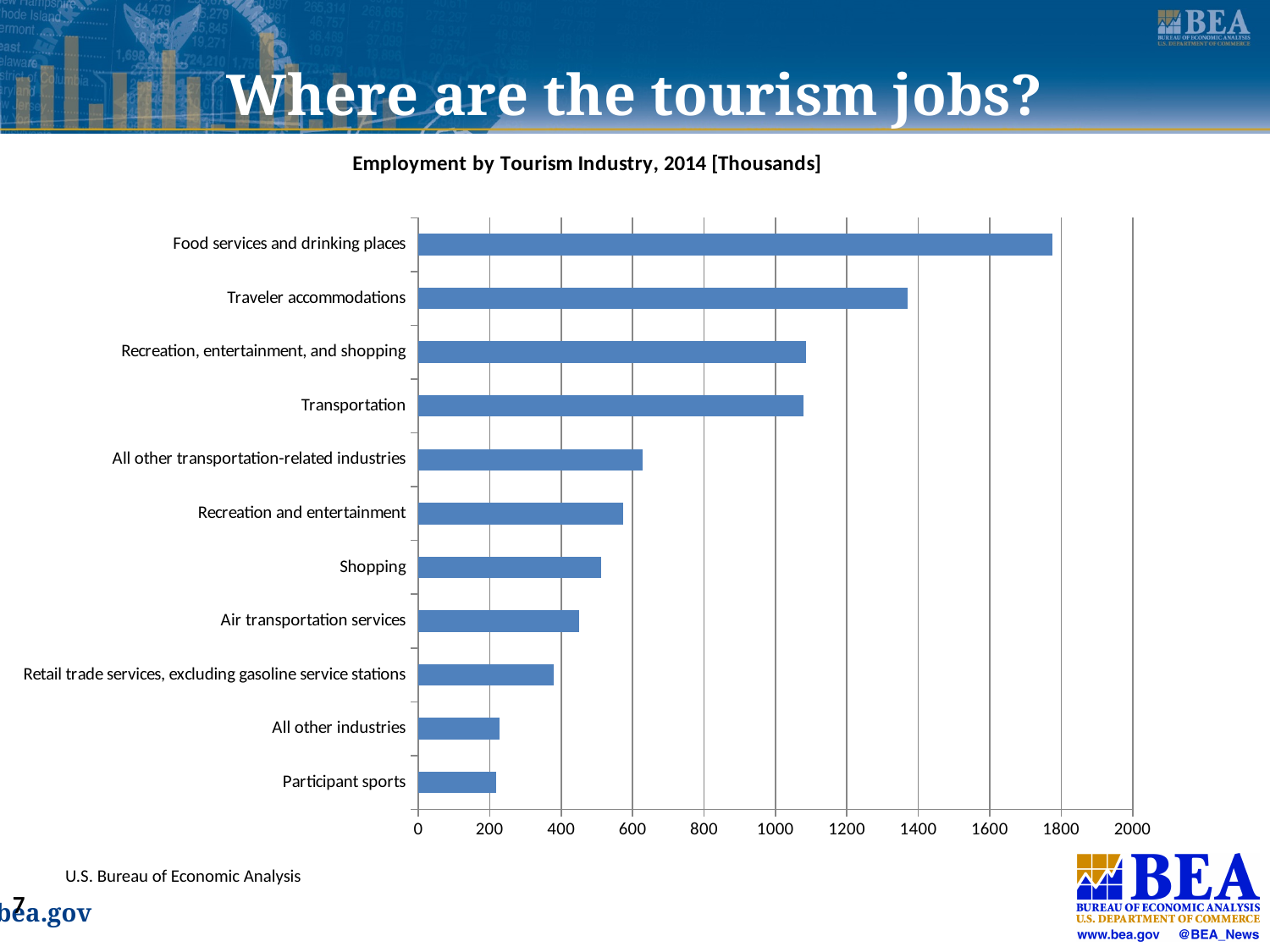
Is the value for Participant sports greater or less than 400? less Which is larger, the value for Traveler accommodations or the value for Recreation, entertainment, and shopping? Traveler accommodations Is the value for Traveler accommodations greater or less than 1400? less What is the title of the chart? Employment by Tourism Industry, 2014 [Thousands] How many industry categories are plotted in the chart? 11 Is the value for Shopping greater or less than 600? less Which industry has the highest employment in the chart? Food services and drinking places What kind of chart is shown on the slide? bar chart Which is larger, the value for Recreation and entertainment or the value for Retail trade services, excluding gasoline service stations? Recreation and entertainment